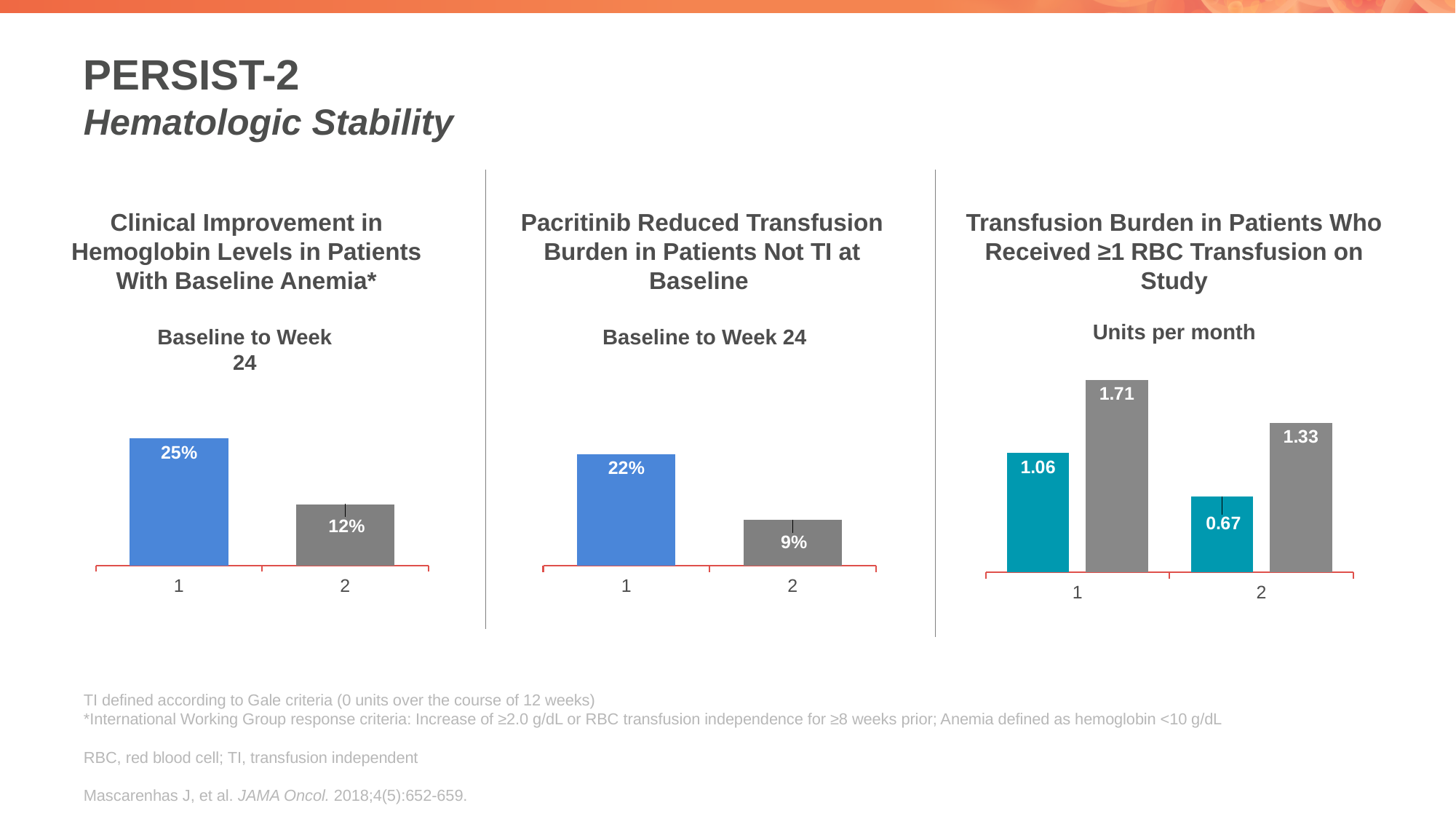
In the right chart (Units per month), what is the value of the teal bar for category 1? 1.06 In the right chart (Units per month), what is the difference between the grey bar and the teal bar for category 2? 0.66 In the left chart (Clinical Improvement in Hemoglobin Levels), what is the value for category 2? 12% In the right chart (Units per month), what is the value of the grey bar for category 2? 1.33 In the middle chart (Pacritinib Reduced Transfusion Burden), what is the value for category 1? 22% In the left chart (Baseline to Week 24, under Clinical Improvement in Hemoglobin Levels), what is the value for category 1? 25% What type of chart is the middle chart (Pacritinib Reduced Transfusion Burden)? Bar chart In the right chart (Units per month), how many bars are plotted in total? 4 In the left chart (Clinical Improvement in Hemoglobin Levels), what is the difference between the values for category 1 and category 2? 13% In the middle chart (Pacritinib Reduced Transfusion Burden), what is the value for category 2? 9% In the middle chart (Pacritinib Reduced Transfusion Burden), which category has the lowest value? 2 In the right chart (Units per month), which bar has the highest value? The grey bar for category 1 (1.71)